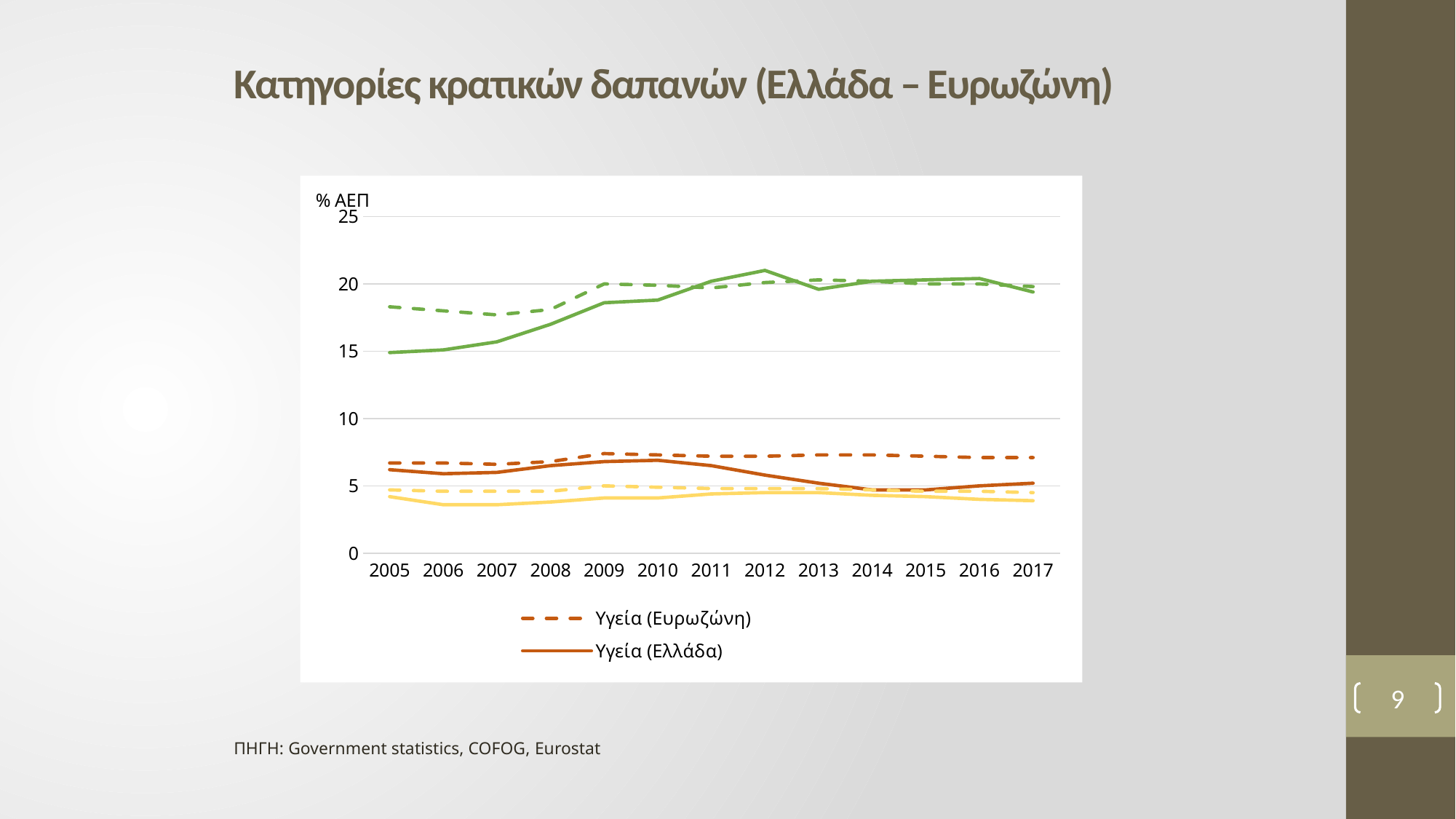
Is the value for Υγεία (Ελλάδα) in 2010 greater or less than 5? greater Does the Υγεία (Ελλάδα) line rise or fall between 2010 and 2014? fall In 2017, which is higher: Υγεία (Ευρωζώνη) or Υγεία (Ελλάδα)? Υγεία (Ευρωζώνη) How many years are shown along the x axis of the chart? 13 Is the value for Υγεία (Ελλάδα) in 2005 greater or less than 5? greater What is the first year shown on the x axis? 2005 What unit is shown on the y axis of the chart? % ΑΕΠ Does the Υγεία (Ελλάδα) line rise or fall between 2006 and 2010? rise Is the value for Υγεία (Ευρωζώνη) in 2012 greater or less than 5? greater What kind of chart is shown on the slide? line chart How many series does the chart legend list? 2